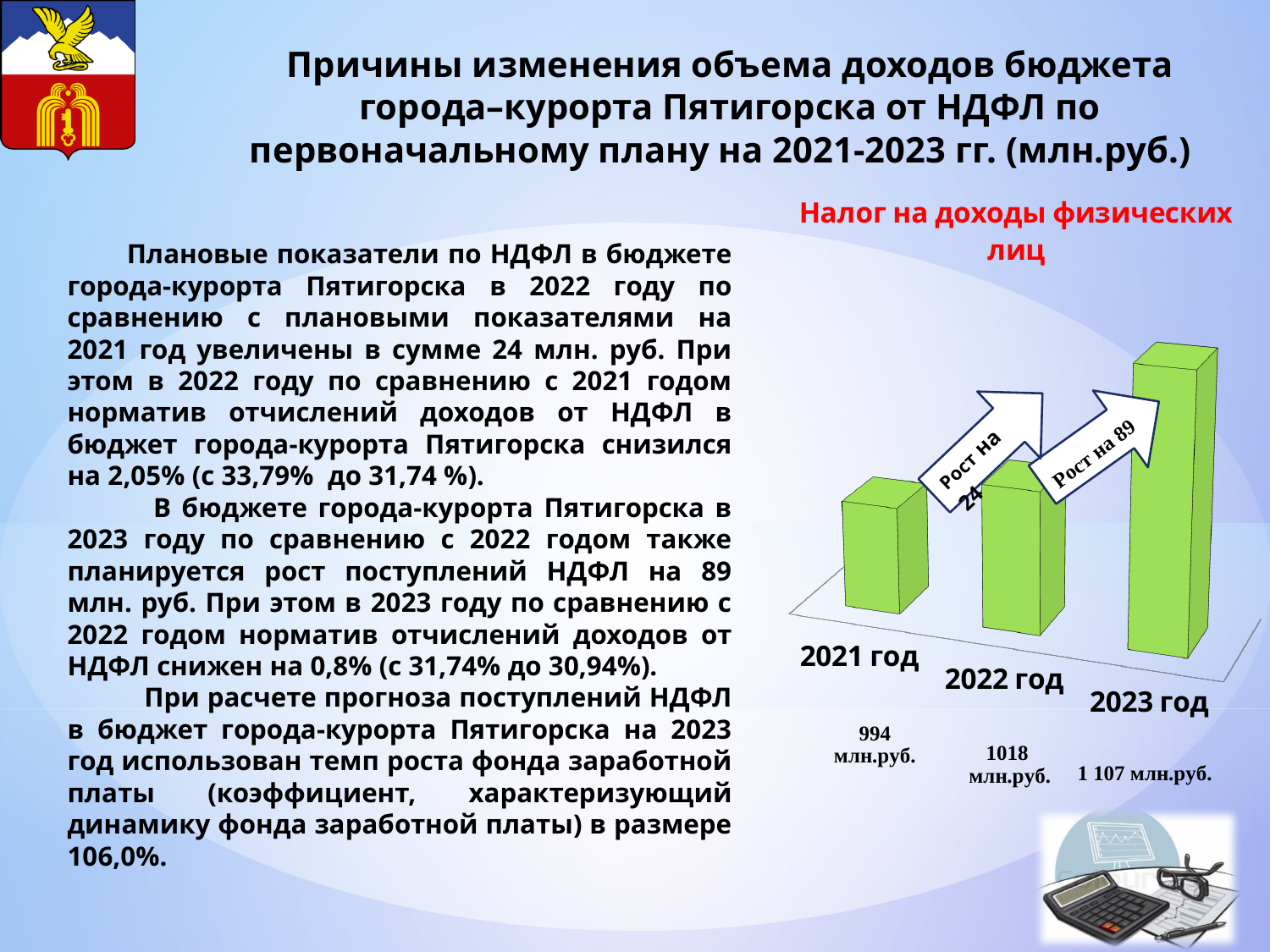
What is the title of the chart? Налог на доходы физических лиц What kind of chart is shown on the slide? Bar chart What is the value for 2022 год on the chart? 1018 млн.руб. How many years (bars) are shown on the chart? 3 Do the values rise or fall from 2021 год to 2023 год? Rise Which is larger, the value for 2021 год or the value for 2023 год? 2023 год What is the value for 2021 год on the chart? 994 млн.руб. By how much does the value for 2023 год exceed the value for 2022 год? 89 млн.руб. By how much does the value for 2022 год exceed the value for 2021 год? 24 млн.руб. What is the value for 2023 год on the chart? 1 107 млн.руб. Which year has the highest value on the chart? 2023 год Which year has the lowest value on the chart? 2021 год